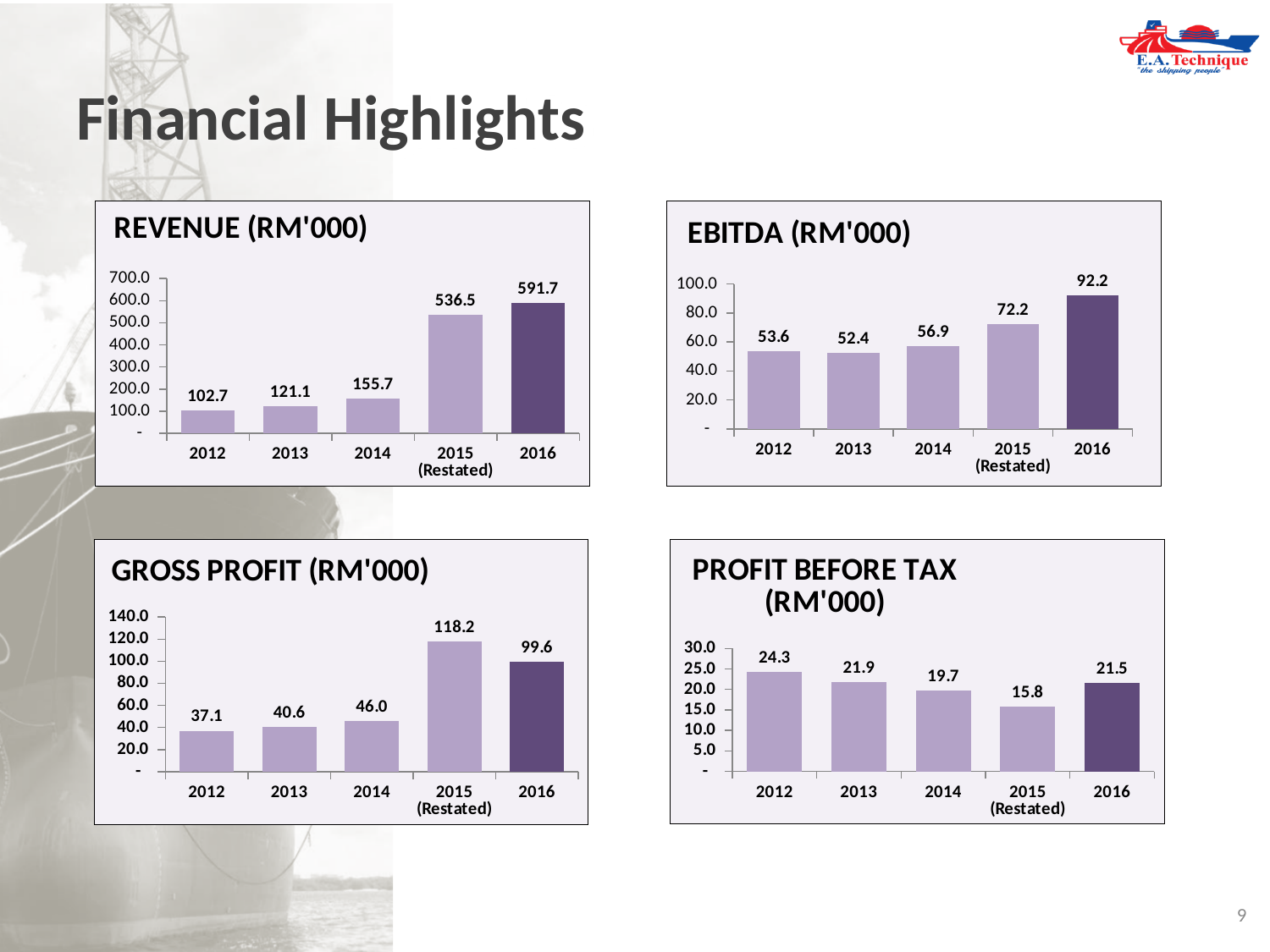
In the GROSS PROFIT (RM'000) chart, which is larger, the value for 2015 (Restated) or 2016? 2015 (Restated) In the EBITDA (RM'000) chart, which year has the highest value? 2016 In the GROSS PROFIT (RM'000) chart, what is the value for 2015 (Restated)? 118.2 In the PROFIT BEFORE TAX (RM'000) chart, what is the value for 2012? 24.3 In the REVENUE (RM'000) chart, which year has the lowest value? 2012 How many years are shown on the x axis of the PROFIT BEFORE TAX (RM'000) chart? 5 What kind of chart is the GROSS PROFIT (RM'000) chart? bar chart In the REVENUE (RM'000) chart, what is the value for 2016? 591.7 In the EBITDA (RM'000) chart, do the values generally rise or fall from 2013 to 2016? rise In the EBITDA (RM'000) chart, what is the value for 2014? 56.9 In the PROFIT BEFORE TAX (RM'000) chart, which year has the lowest value? 2015 (Restated) In the REVENUE (RM'000) chart, what is the difference between the 2016 and 2015 (Restated) values? 55.2